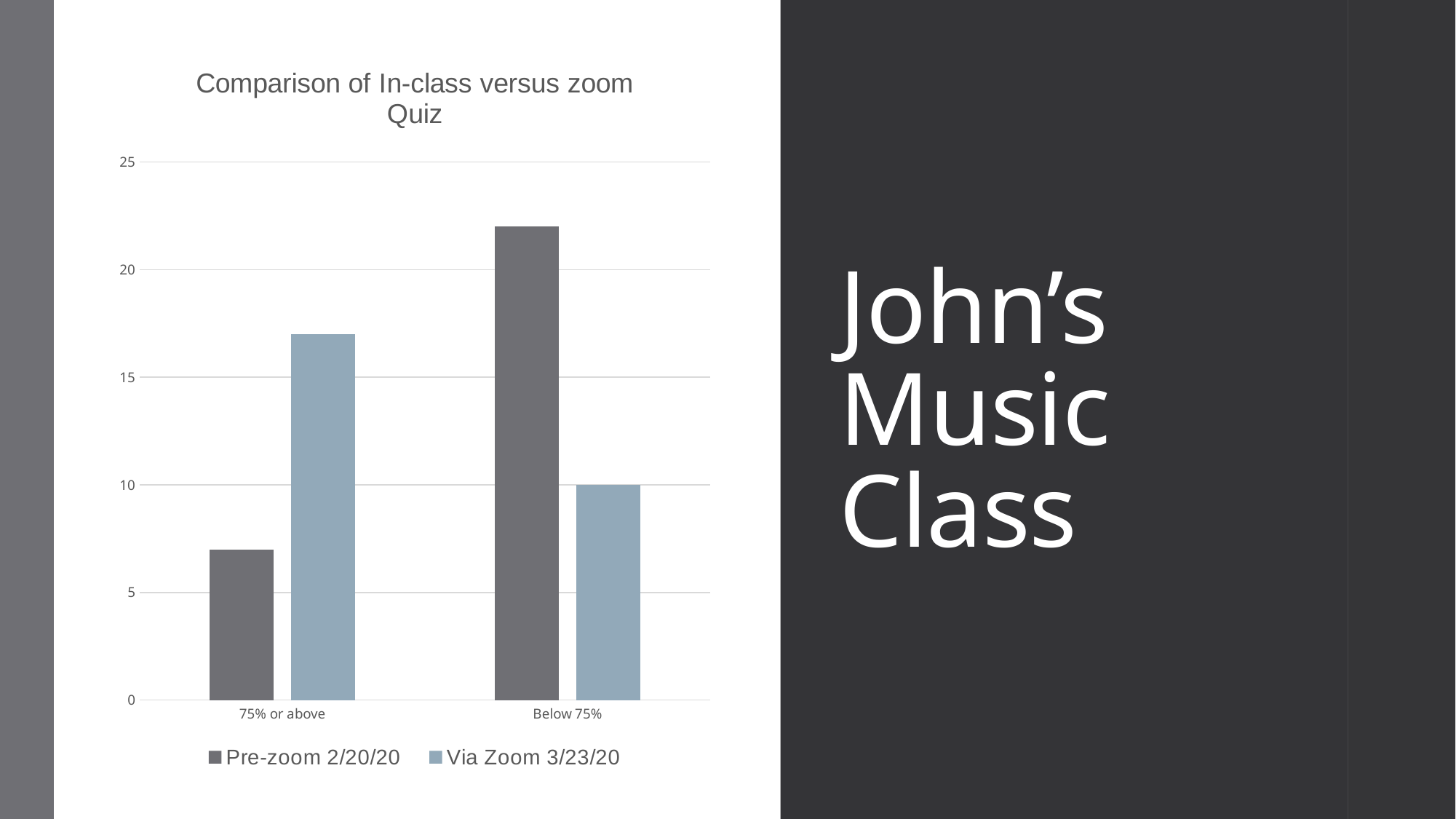
Which category has the highest Pre-zoom 2/20/20 value? Below 75% What kind of chart is shown on the slide? bar chart How many series does the legend list? 2 How many categories are shown on the x axis? 2 Is the value for Via Zoom 3/23/20 in the 75% or above category greater or less than 15? greater Is the value for Pre-zoom 2/20/20 in the Below 75% category greater or less than 20? greater In the 75% or above category, which series has the larger value, Pre-zoom 2/20/20 or Via Zoom 3/23/20? Via Zoom 3/23/20 Is the value for Pre-zoom 2/20/20 in the 75% or above category greater or less than 10? less What is the value for Via Zoom 3/23/20 in the Below 75% category? 10 Which category has the lowest Via Zoom 3/23/20 value? Below 75% Which series is shown in the lighter blue-grey colour? Via Zoom 3/23/20 What is the title of the chart? Comparison of In-class versus zoom Quiz